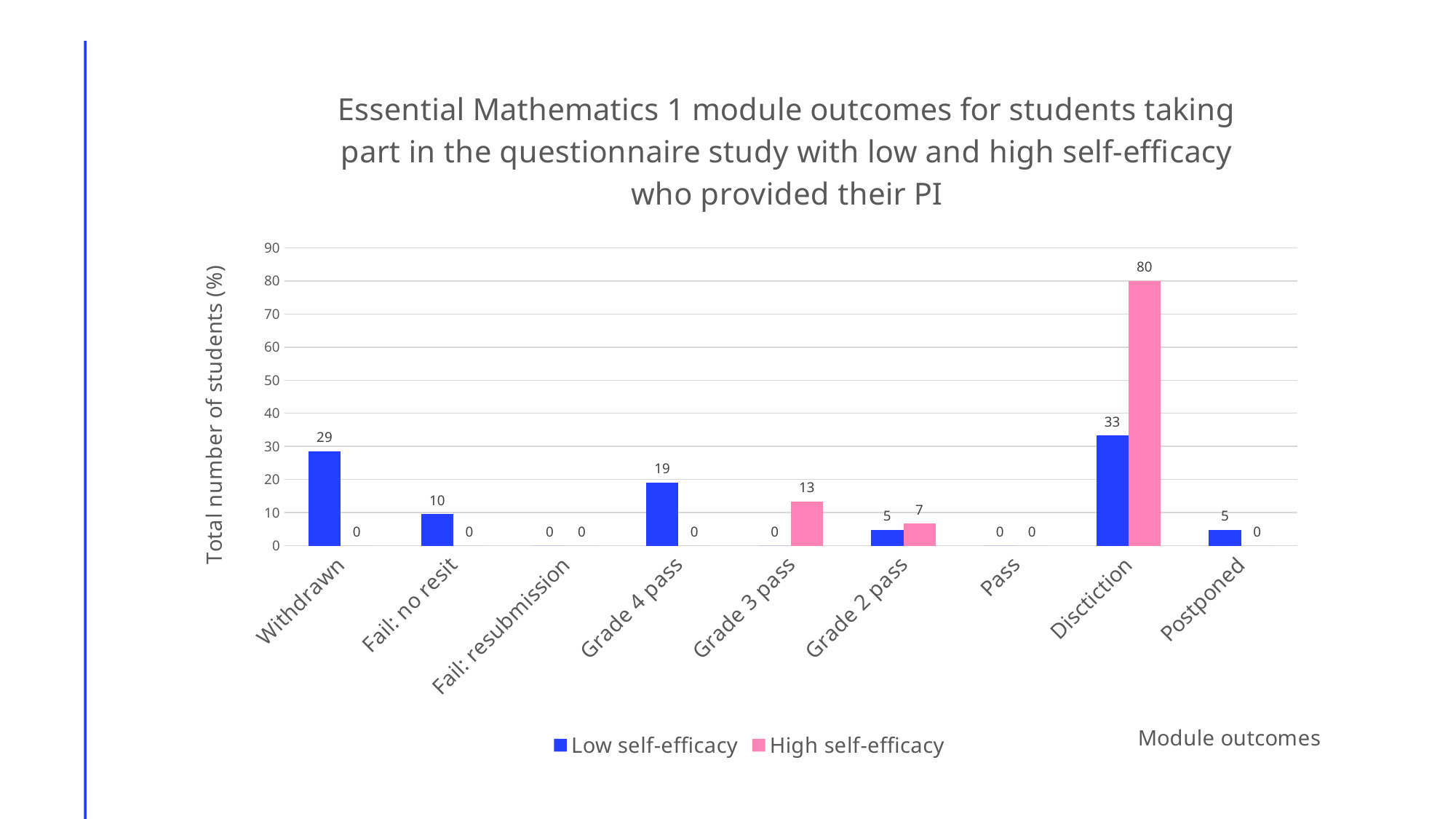
What is the Low self-efficacy value for Withdrawn? 29 For Grade 2 pass, which series has the larger value, Low self-efficacy or High self-efficacy? High self-efficacy What is the High self-efficacy value for Grade 3 pass? 13 What kind of chart is shown on the slide? Bar chart What is the High self-efficacy value for Disctiction? 80 What is the difference between the High self-efficacy and Low self-efficacy values for Disctiction? 47 Which module outcome has the highest High self-efficacy value? Disctiction Which module outcome has the highest Low self-efficacy value? Disctiction How many module outcome categories are shown on the x axis? 9 What is the Low self-efficacy value for Fail: no resit? 10 What is the label of the y axis? Total number of students (%) How many series does the legend list? 2